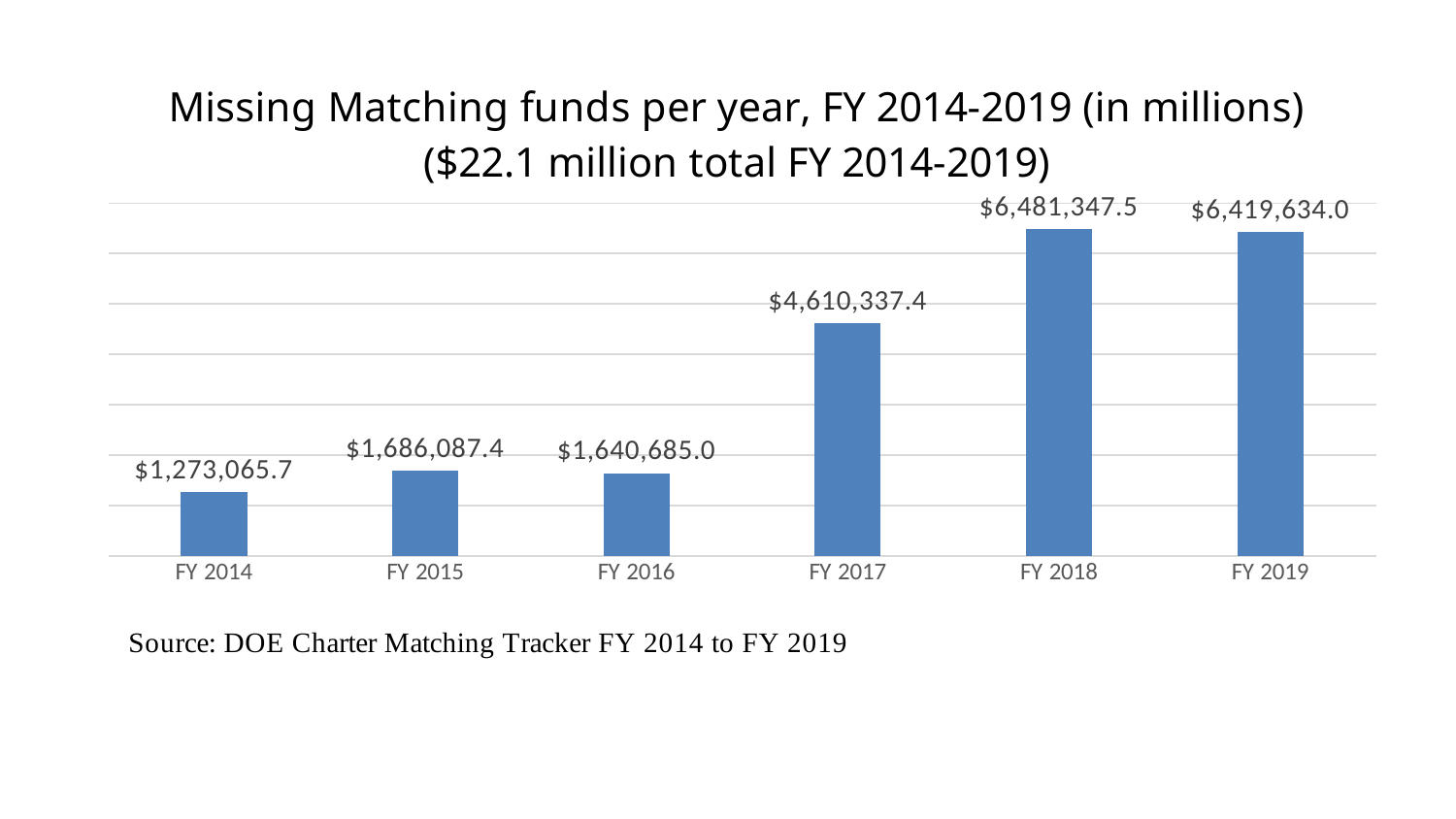
Which fiscal year has the highest value? FY 2018 What is the value for FY 2017? $4,610,337.4 Which is larger, the value for FY 2015 or FY 2016? FY 2015 What kind of chart is shown on the slide? Bar chart Do the values generally rise or fall from FY 2014 to FY 2019? Rise What is the difference between the values for FY 2018 and FY 2019? $61,713.5 Which fiscal year has the lowest value? FY 2014 According to the chart title, what is the total of missing matching funds for FY 2014-2019? $22.1 million What is the difference between the values for FY 2017 and FY 2016? $2,969,652.4 How many fiscal years are shown on the x axis? 6 What is the value for FY 2019? $6,419,634.0 What is the value for FY 2014? $1,273,065.7